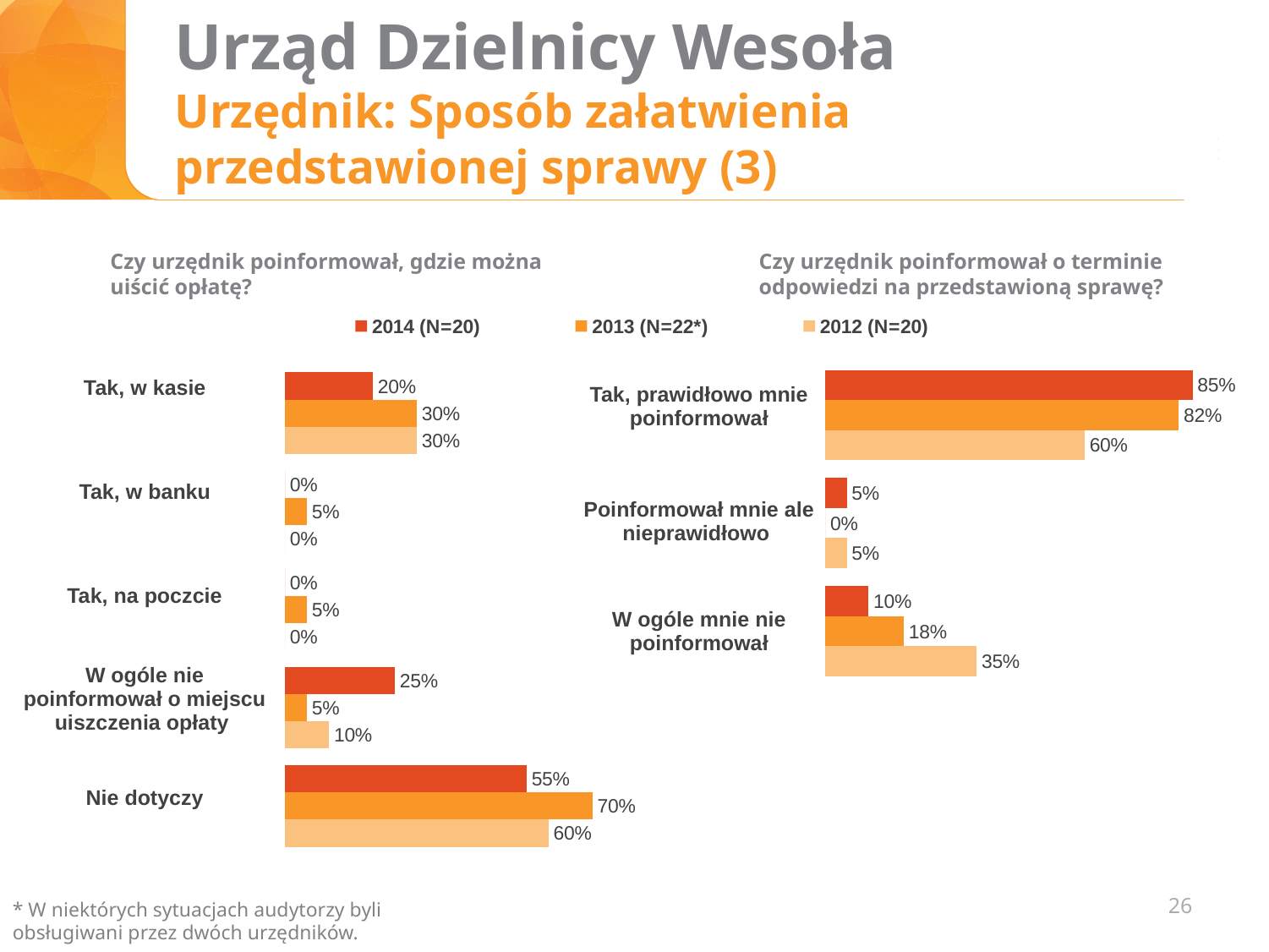
What type of chart is used on this slide? Bar chart In the left chart ("Czy urzędnik poinformował, gdzie można uiścić opłatę?"), which category has the highest value for 2014 (N=20)? Nie dotyczy How many series does the legend list? 3 In the right chart ("Czy urzędnik poinformował o terminie odpowiedzi na przedstawioną sprawę?"), what is the difference between the 2014 and 2013 values for "Tak, prawidłowo mnie poinformował"? 3 percentage points In the left chart ("Czy urzędnik poinformował, gdzie można uiścić opłatę?"), what is the difference between the 2014 and 2012 values for "W ogóle nie poinformował o miejscu uiszczenia opłaty"? 15 percentage points In the right chart ("Czy urzędnik poinformował o terminie odpowiedzi na przedstawioną sprawę?"), which year has the lowest value for "Tak, prawidłowo mnie poinformował"? 2012 (N=20) In the left chart ("Czy urzędnik poinformował, gdzie można uiścić opłatę?"), what is the value for "Nie dotyczy" in 2013 (N=22*)? 70% In the right chart ("Czy urzędnik poinformował o terminie odpowiedzi na przedstawioną sprawę?"), is the 2014 value for "W ogóle mnie nie poinformował" larger or smaller than the 2012 value? smaller In the left chart ("Czy urzędnik poinformował, gdzie można uiścić opłatę?"), how many categories are shown? 5 In the right chart ("Czy urzędnik poinformował o terminie odpowiedzi na przedstawioną sprawę?"), what is the value for "W ogóle mnie nie poinformował" in 2013 (N=22*)? 18% In the left chart ("Czy urzędnik poinformował, gdzie można uiścić opłatę?"), what is the value for "Tak, w kasie" in 2014 (N=20)? 20% In the right chart ("Czy urzędnik poinformował o terminie odpowiedzi na przedstawioną sprawę?"), what is the value for "Tak, prawidłowo mnie poinformował" in 2012 (N=20)? 60%